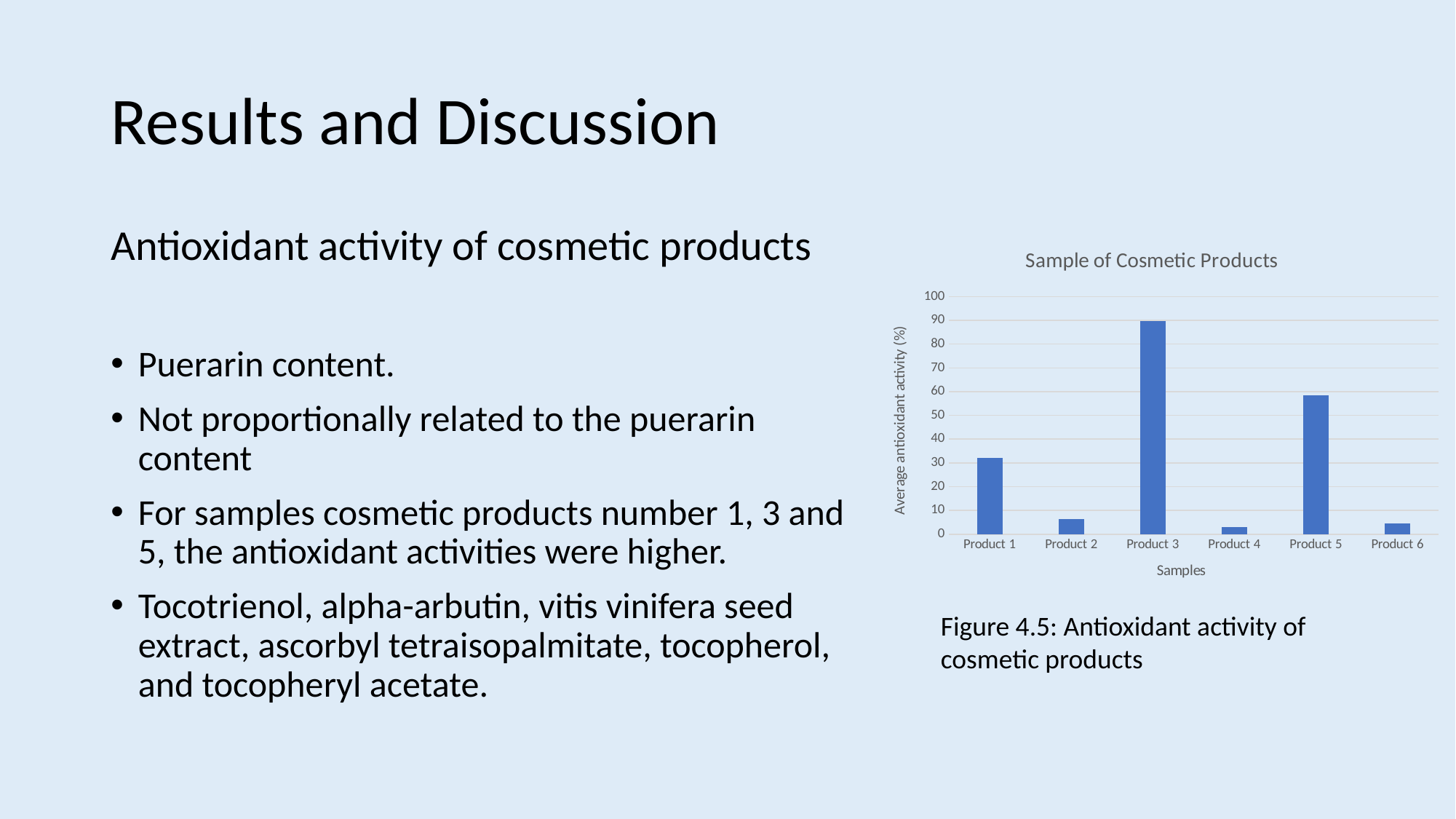
Is the value for Product 4 greater or less than 10? less What is the title of the chart? Sample of Cosmetic Products Which has a higher average antioxidant activity, Product 1 or Product 5? Product 5 How many products are shown on the x axis of the chart? 6 Is the value for Product 1 greater or less than 40? less Is the value for Product 3 greater or less than 80? greater Which has a higher average antioxidant activity, Product 2 or Product 1? Product 1 What kind of chart is shown on the slide? Bar chart Which product has the highest average antioxidant activity? Product 3 What is the label of the vertical axis of the chart? Average antioxidant activity (%)